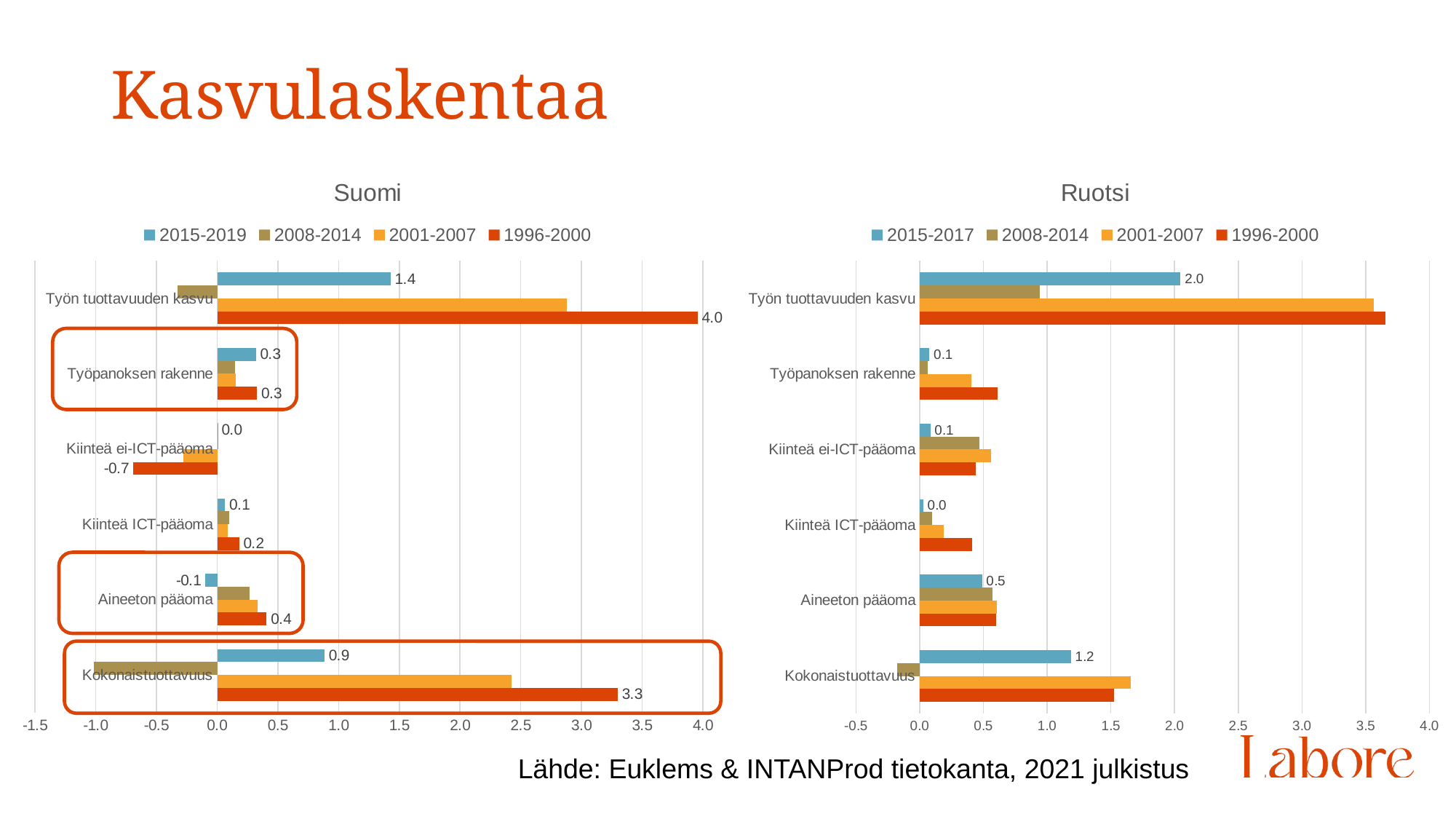
In the Ruotsi chart, is the 1996-2000 value for Työn tuottavuuden kasvu greater or less than 3.5? greater In the Ruotsi chart, what is the value for Aineeton pääoma in the 2015-2017 series? 0.5 How many series does the legend of the Suomi chart list? 4 In the Suomi chart, what is the value for Kiinteä ei-ICT-pääoma in the 1996-2000 series? -0.7 What type of chart is the Ruotsi chart? Bar chart In the Suomi chart, which category has the highest value in the 1996-2000 series? Työn tuottavuuden kasvu In the Suomi chart, what is the value for Työn tuottavuuden kasvu in the 2015-2019 series? 1.4 In the Suomi chart, what is the difference between the 1996-2000 and 2015-2019 values for Työn tuottavuuden kasvu? 2.6 In the Suomi chart, which category has the lowest value in the 1996-2000 series? Kiinteä ei-ICT-pääoma In the Suomi chart, what is the value for Kokonaistuottavuus in the 1996-2000 series? 3.3 How many categories are shown in the Ruotsi chart? 6 In the Ruotsi chart, which is larger for the 2015-2017 series: Kokonaistuottavuus or Aineeton pääoma? Kokonaistuottavuus